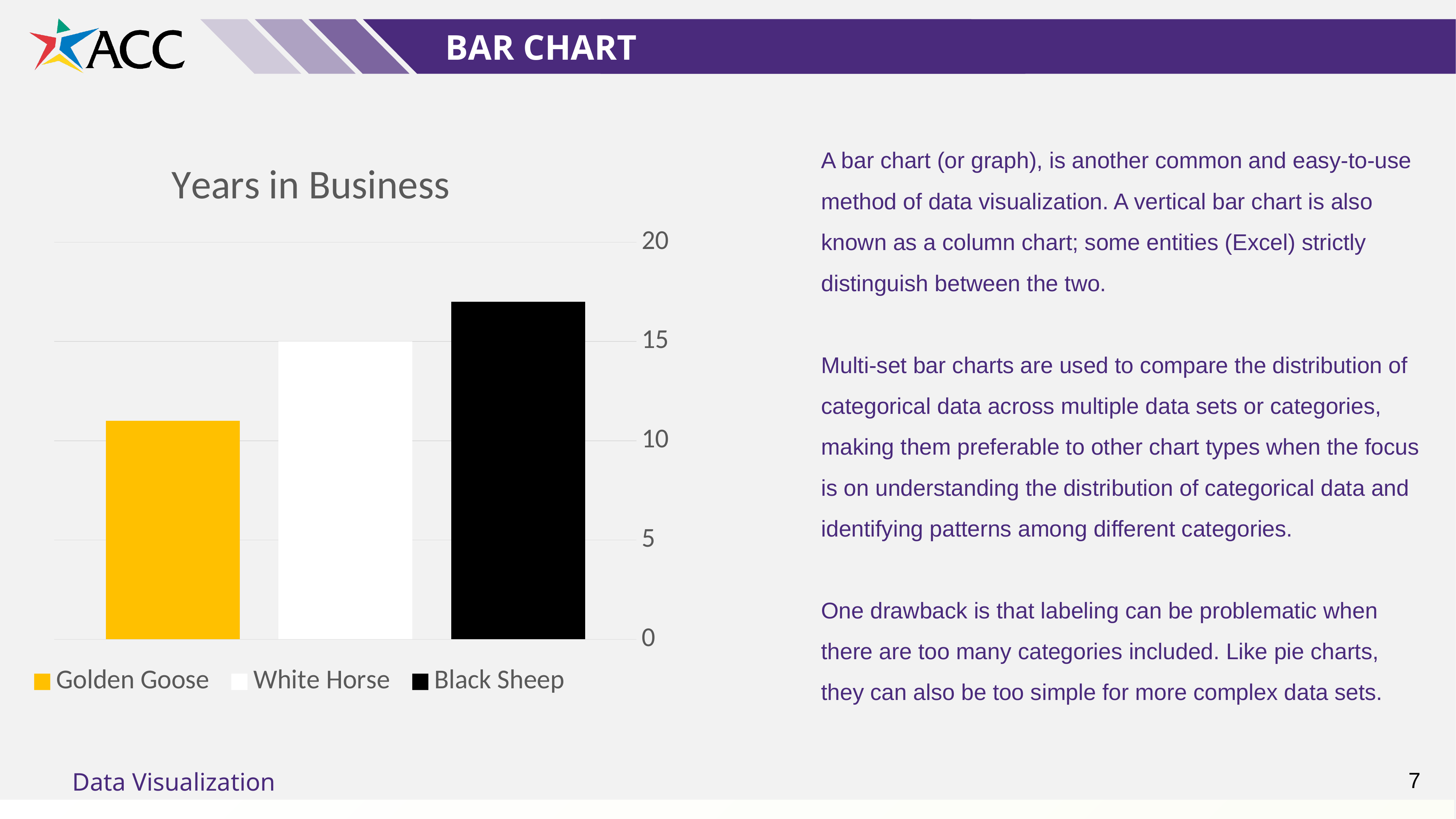
Is the value for Golden Goose greater or less than 10? greater Which is larger, the value for Golden Goose or the value for White Horse? White Horse How many entries does the legend list? 3 Which company has the lowest value in the Years in Business chart? Golden Goose Which company has the highest value in the Years in Business chart? Black Sheep Is the value for Black Sheep greater or less than 20? less How many bars are plotted in the chart? 3 What is the value for White Horse in the Years in Business chart? 15 Is the value for Black Sheep greater or less than 15? greater What kind of chart is shown on the slide? bar chart Do the bar values rise or fall from left to right across the chart? rise What is the title of the chart? Years in Business